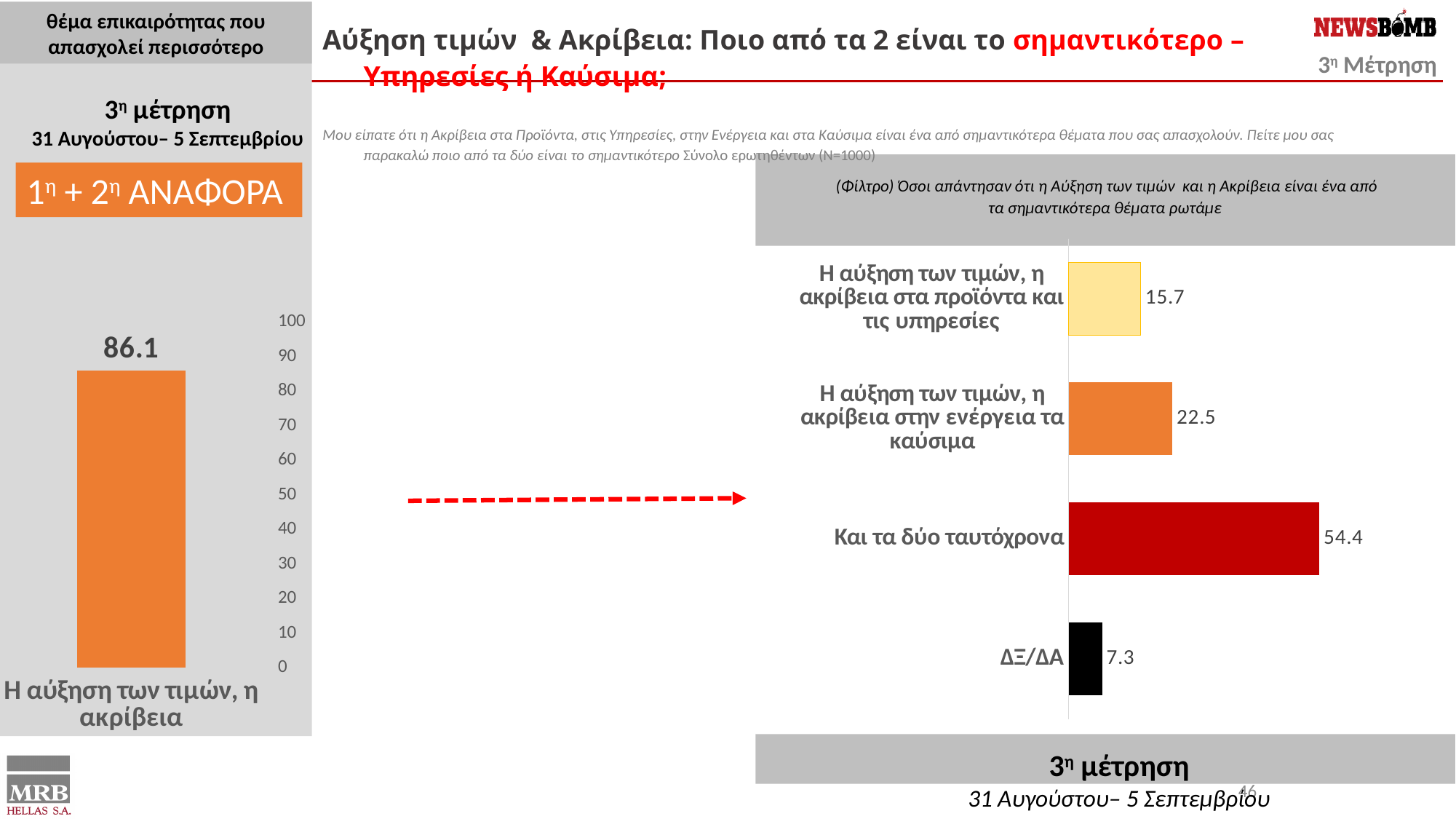
In the bar chart on the right, what is the value for 'Και τα δύο ταυτόχρονα'? 54.4 In the bar chart on the right, what is the value for 'Η αύξηση των τιμών, η ακρίβεια στα προϊόντα και τις υπηρεσίες'? 15.7 In the bar chart on the right, which category has the lowest value? ΔΞ/ΔΑ In the bar chart on the right, which category has the highest value? Και τα δύο ταυτόχρονα How many categories are shown in the bar chart on the right? 4 In the bar chart on the right, what is the value for 'Η αύξηση των τιμών, η ακρίβεια στην ενέργεια τα καύσιμα'? 22.5 In the chart on the left, is the value for 'Η αύξηση των τιμών, η ακρίβεια' greater or less than 80? greater In the bar chart on the right, what is the value for 'ΔΞ/ΔΑ'? 7.3 What type of chart is shown on the right side of the slide? Bar chart In the bar chart on the right, what is the difference between the value for 'Και τα δύο ταυτόχρονα' and the value for 'Η αύξηση των τιμών, η ακρίβεια στην ενέργεια τα καύσιμα'? 31.9 In the chart on the left, what is the value for 'Η αύξηση των τιμών, η ακρίβεια'? 86.1 In the bar chart on the right, which is larger: the value for 'Η αύξηση των τιμών, η ακρίβεια στην ενέργεια τα καύσιμα' or the value for 'Η αύξηση των τιμών, η ακρίβεια στα προϊόντα και τις υπηρεσίες'? Η αύξηση των τιμών, η ακρίβεια στην ενέργεια τα καύσιμα